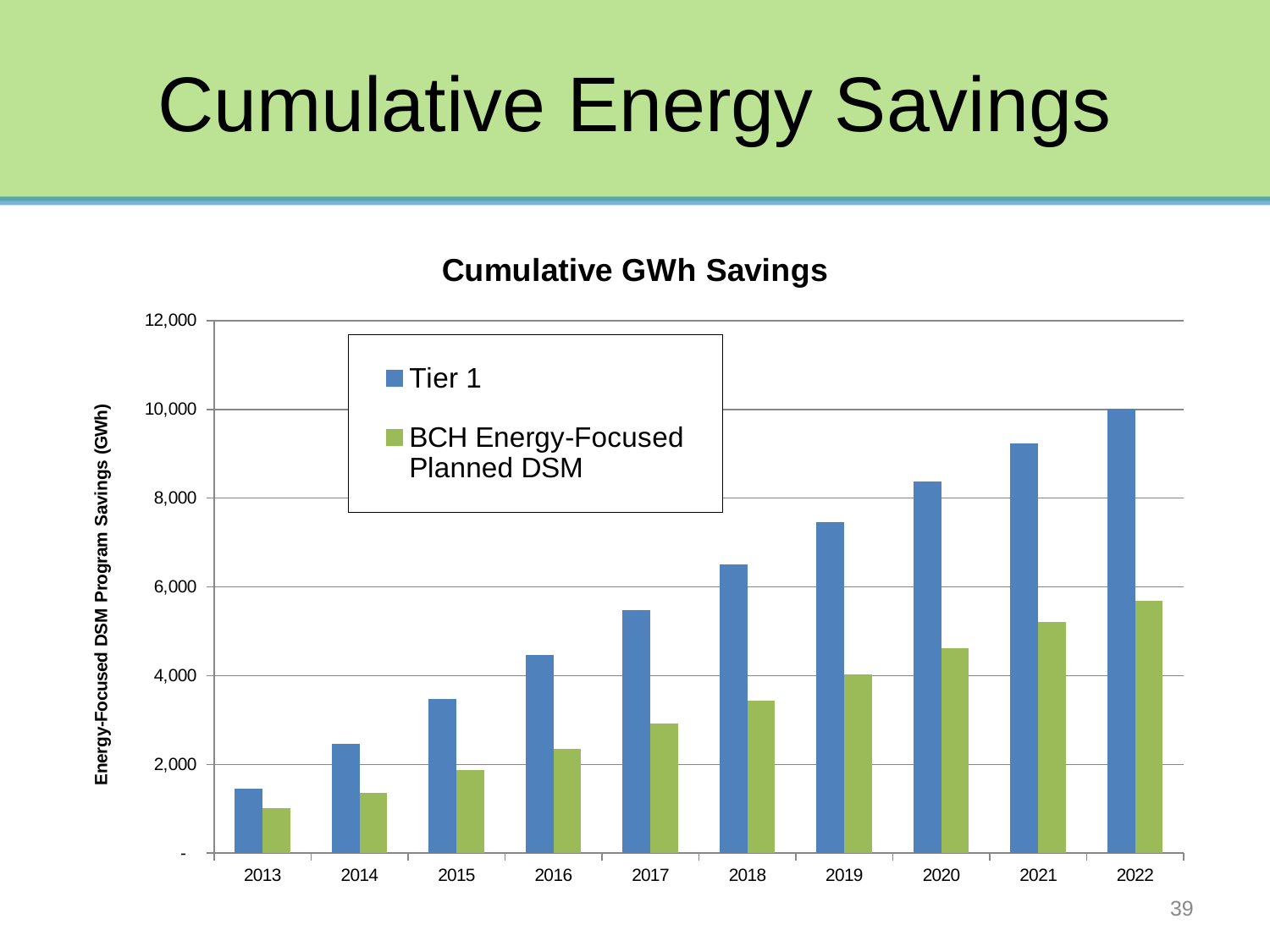
Is the Tier 1 value for 2018 greater or less than 6,000? greater What type of chart is shown on the slide? bar chart Is the BCH Energy-Focused Planned DSM value for 2022 greater or less than 6,000? less What is the title of the chart? Cumulative GWh Savings Which year has the lowest BCH Energy-Focused Planned DSM value? 2013 Do the Tier 1 values rise or fall from 2013 to 2022? rise How many years are shown on the x axis? 10 Which year has the highest Tier 1 value? 2022 In 2020, which series has the larger value, Tier 1 or BCH Energy-Focused Planned DSM? Tier 1 Is the Tier 1 value for 2015 greater or less than 4,000? less How many series does the legend list? 2